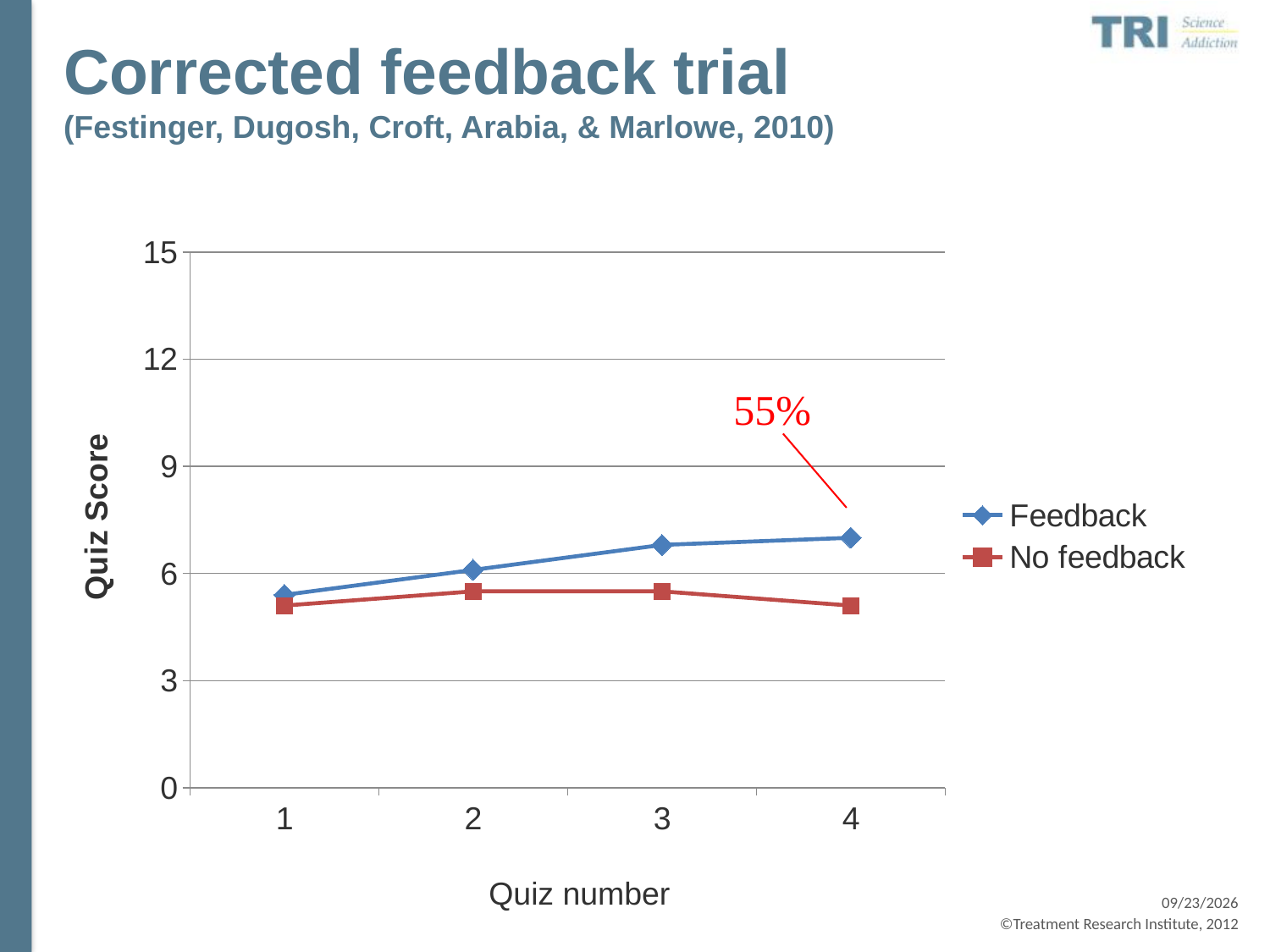
Is the Feedback score at quiz 4 greater or less than 6? greater What percentage is annotated next to the Feedback point at quiz 4? 55% How many quiz numbers are plotted along the x axis? 4 How many series does the legend list? 2 Is the No feedback score at quiz 4 greater or less than 6? less At quiz 3, which series has the higher quiz score, Feedback or No feedback? Feedback Does the Feedback series rise or fall from quiz 1 to quiz 4? rise What kind of chart is shown on the slide? line chart At which quiz number is the Feedback score lowest? 1 At quiz 4, which series has the higher quiz score, Feedback or No feedback? Feedback Is the Feedback score at quiz 1 greater or less than 6? less